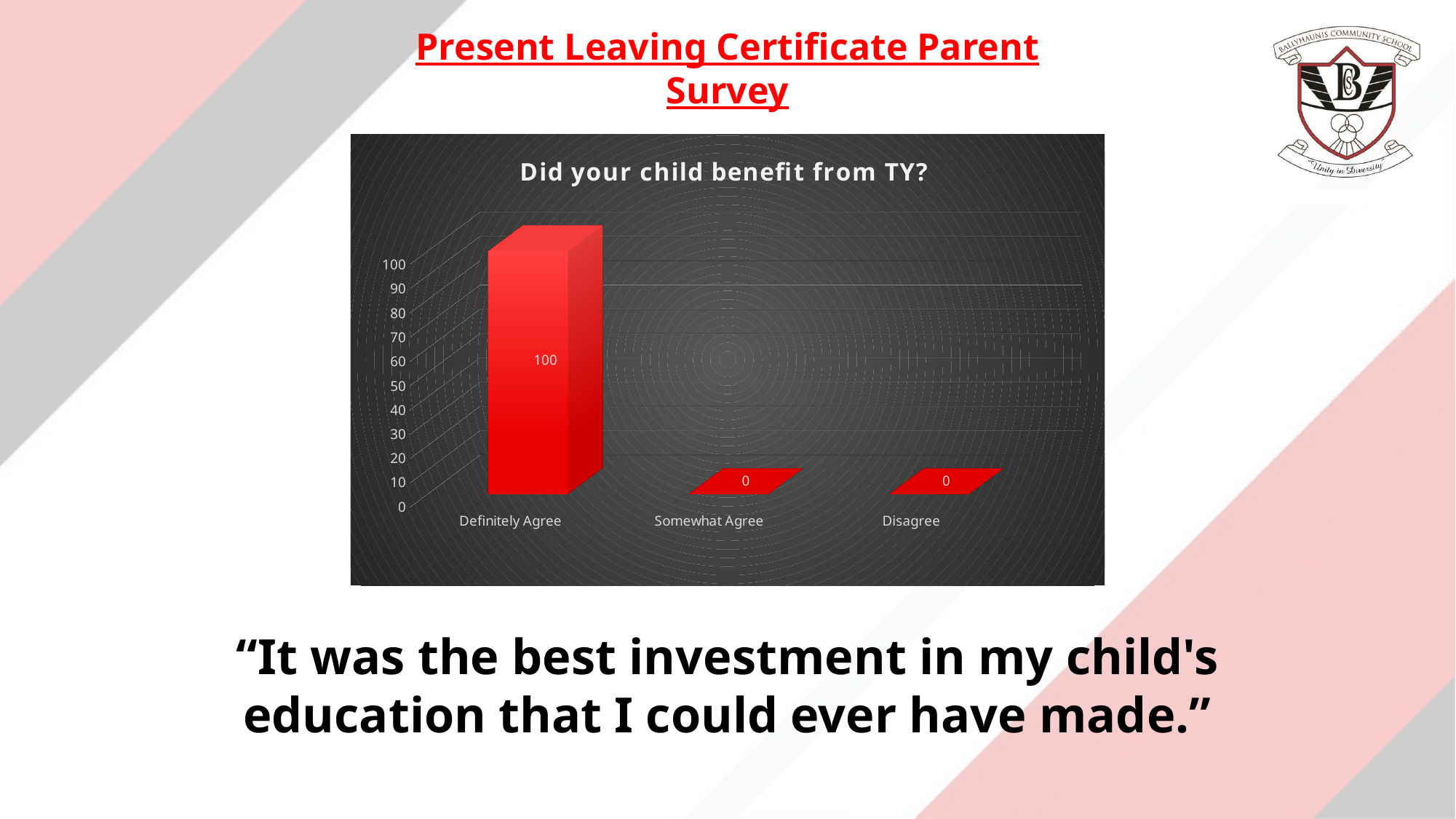
Is the value for Definitely Agree greater or less than 50? greater What is the total of the values for all three categories? 100 What is the title of the chart? Did your child benefit from TY? What is the highest value shown on the vertical axis? 100 Which is larger, the value for Definitely Agree or the value for Somewhat Agree? Definitely Agree What is the value for Somewhat Agree? 0 What is the value for Disagree? 0 Which category has the highest value? Definitely Agree How many categories are shown on the x axis? 3 What kind of chart is shown on the slide? bar chart What is the value for Definitely Agree? 100 What is the difference between the values for Definitely Agree and Disagree? 100